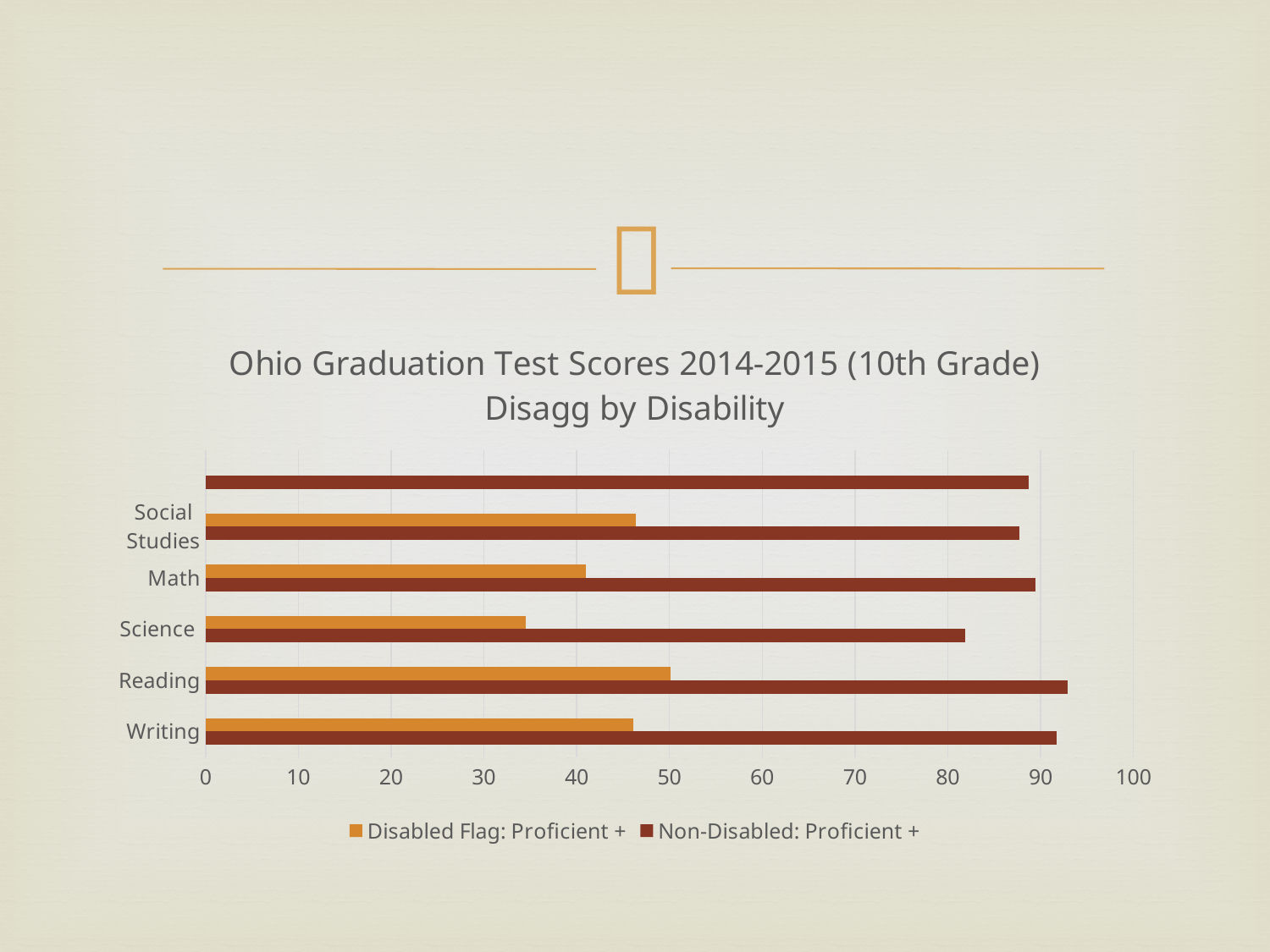
Which series is shown in the darker red-brown colour? Non-Disabled: Proficient + Is the Disabled Flag: Proficient + value for Writing greater or less than 50? less What kind of chart is shown on the slide? bar chart Which subject has the highest value for Disabled Flag: Proficient +? Reading How many series does the legend list? 2 Is the Disabled Flag: Proficient + value for Science greater or less than 40? less Is the Non-Disabled: Proficient + value for Reading greater or less than 90? greater Which is larger for Disabled Flag: Proficient +: Math or Science? Math What is the title of the chart? Ohio Graduation Test Scores 2014-2015 (10th Grade) Disagg by Disability Which subject has the lowest value for Non-Disabled: Proficient +? Science For Science, which series has the larger value: Disabled Flag: Proficient + or Non-Disabled: Proficient +? Non-Disabled: Proficient + Which subject has the lowest value for Disabled Flag: Proficient +? Science